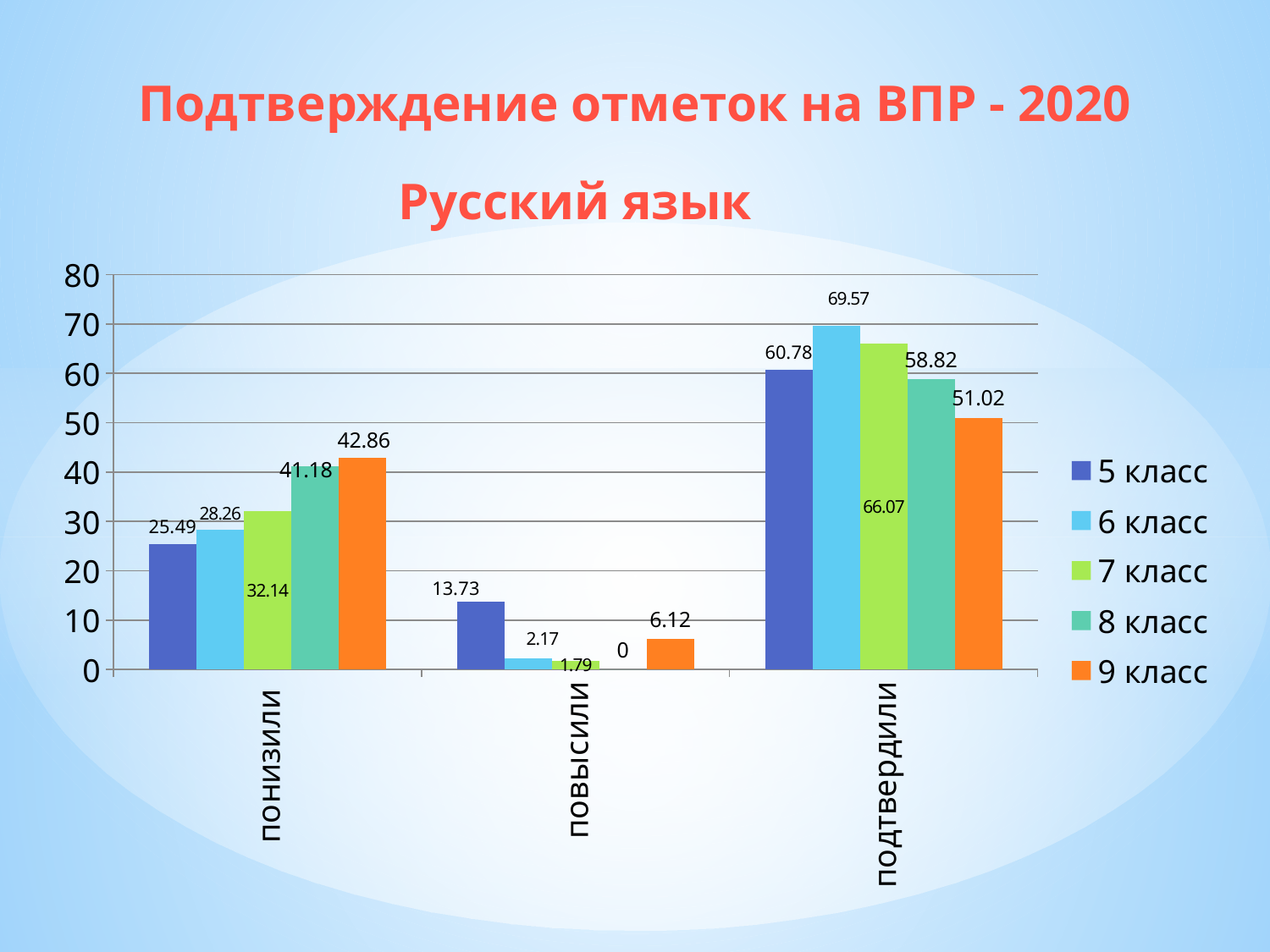
What is the value for 6 класс in the подтвердили category? 69.57 Which is larger in the повысили category: the value for 5 класс or the value for 9 класс? 5 класс Which class has the highest value in the подтвердили category? 6 класс What is the subtitle of the chart below the main title? Русский язык How many categories are shown on the x axis? 3 Is the value for 7 класс in the подтвердили category greater or less than 60? greater Which class has the lowest value in the понизили category? 5 класс What kind of chart is shown on the slide? bar chart How many series does the legend list? 5 What is the difference between the 9 класс and 5 класс values in the подтвердили category? 9.76 What is the value for 8 класс in the повысили category? 0 What is the value for 9 класс in the понизили category? 42.86